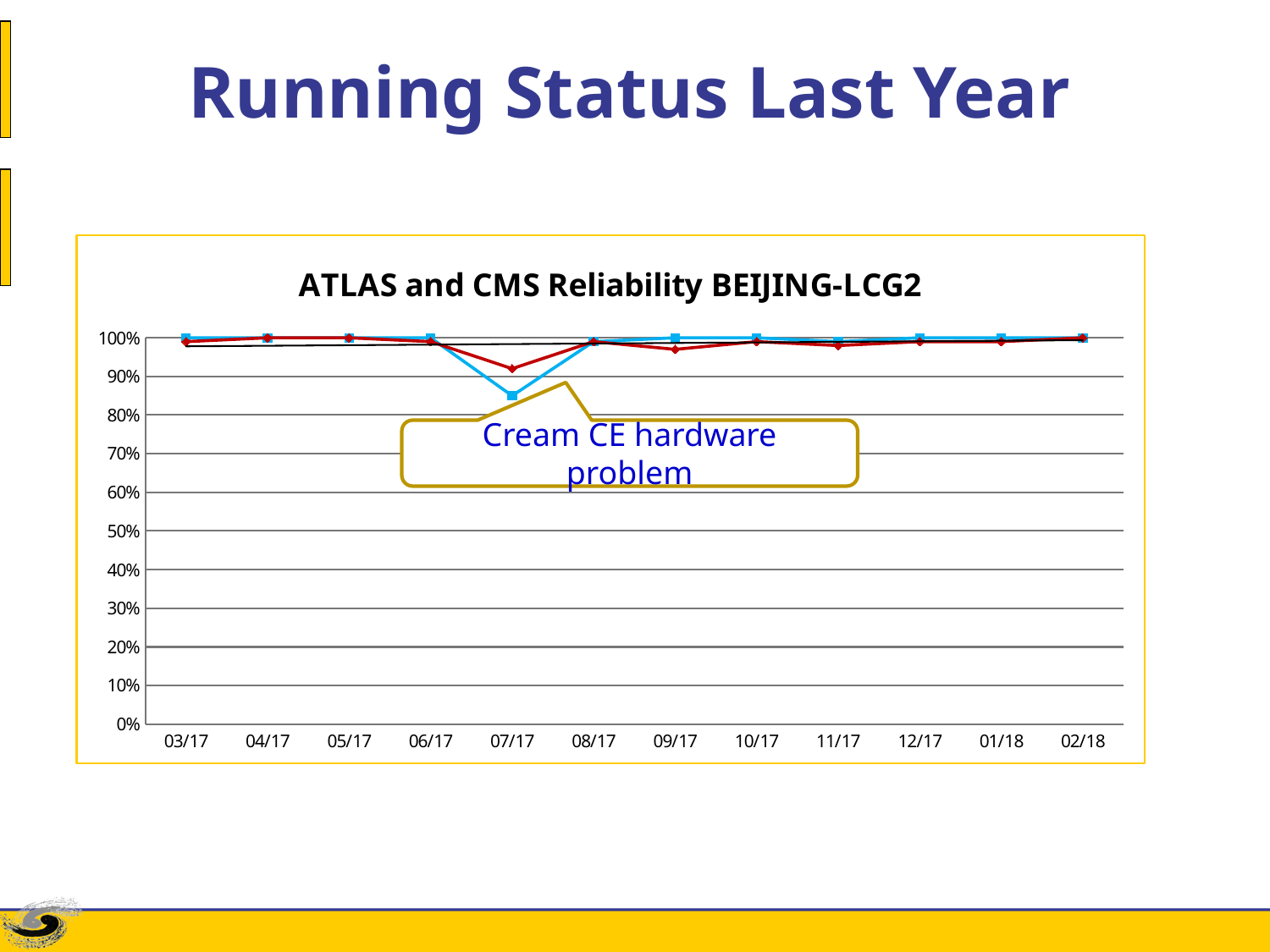
Is the value of the red line at 07/17 greater or less than 90%? greater What is the title of the chart? ATLAS and CMS Reliability BEIJING-LCG2 In which month does the red line reach its lowest value? 07/17 Is the value of the blue line at 03/17 greater or less than 90%? greater Is the value of the blue line at 07/17 greater or less than 80%? greater What type of chart is shown on the slide? line chart How many months are shown along the x axis of the chart? 12 What is the highest percentage shown on the y axis of the chart? 100% At 07/17, which line has the higher value, the blue line or the red line? the red line In which month does the blue line reach its lowest value? 07/17 Which month is the first on the x axis of the chart? 03/17